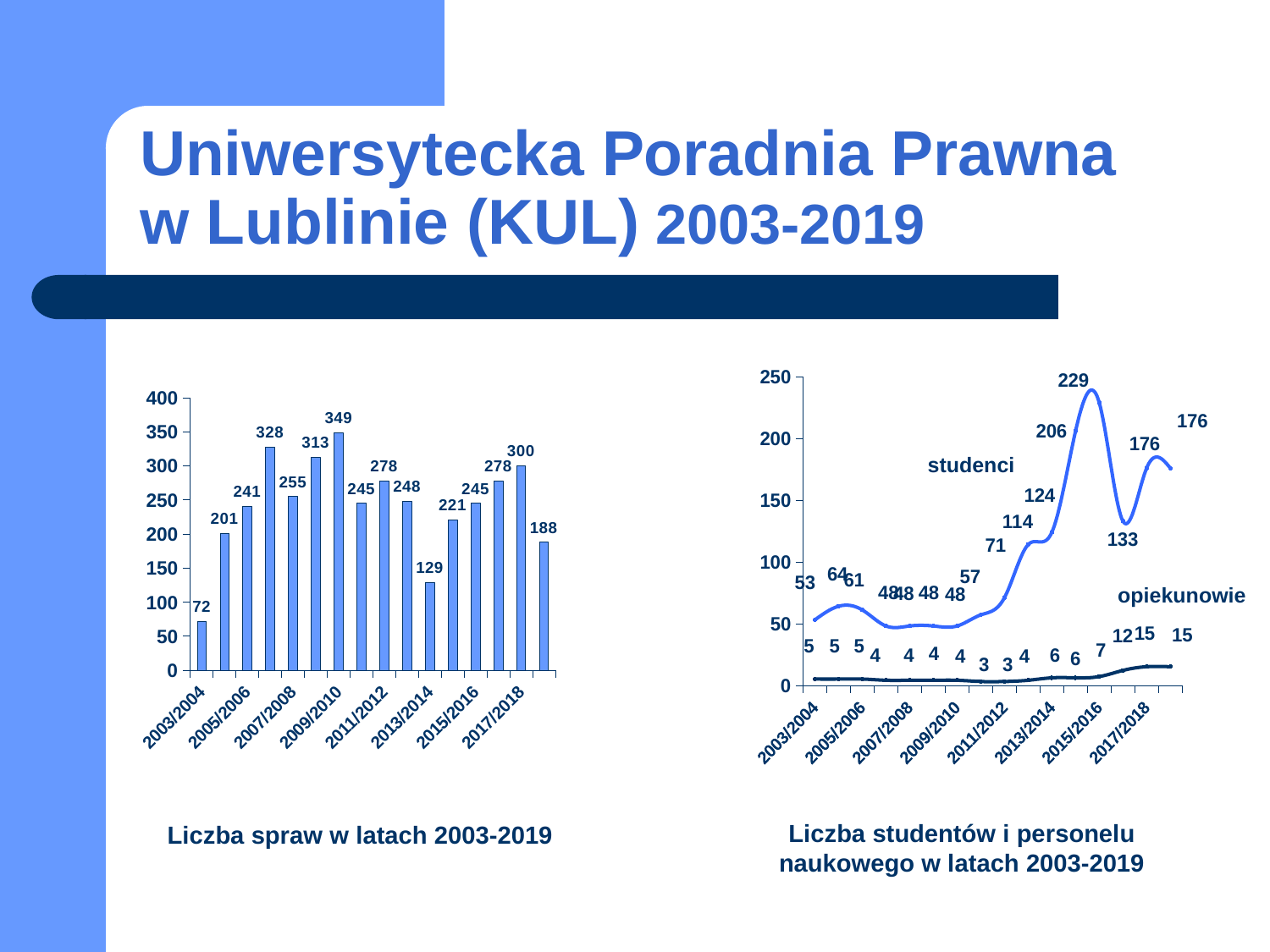
In the right chart 'Liczba studentów i personelu naukowego w latach 2003-2019', what is the lowest value of the 'opiekunowie' series? 3 In the left chart 'Liczba spraw w latach 2003-2019', what is the value for 2017/2018? 300 In the left chart 'Liczba spraw w latach 2003-2019', what is the lowest value shown? 72 In the right chart 'Liczba studentów i personelu naukowego w latach 2003-2019', what is the highest value of the 'studenci' series? 229 How many series are plotted in the right chart 'Liczba studentów i personelu naukowego w latach 2003-2019'? 2 How many bars are plotted in the left chart 'Liczba spraw w latach 2003-2019'? 16 In the right chart 'Liczba studentów i personelu naukowego w latach 2003-2019', what is the value of 'studenci' for 2003/2004? 53 In the left chart 'Liczba spraw w latach 2003-2019', what is the value for 2013/2014? 129 What kind of chart is the right chart, 'Liczba studentów i personelu naukowego w latach 2003-2019'? line chart In the left chart 'Liczba spraw w latach 2003-2019', what is the difference between the highest value (349) and the lowest value (72)? 277 In the left chart 'Liczba spraw w latach 2003-2019', what is the highest value shown? 349 What kind of chart is the left chart, 'Liczba spraw w latach 2003-2019'? bar chart